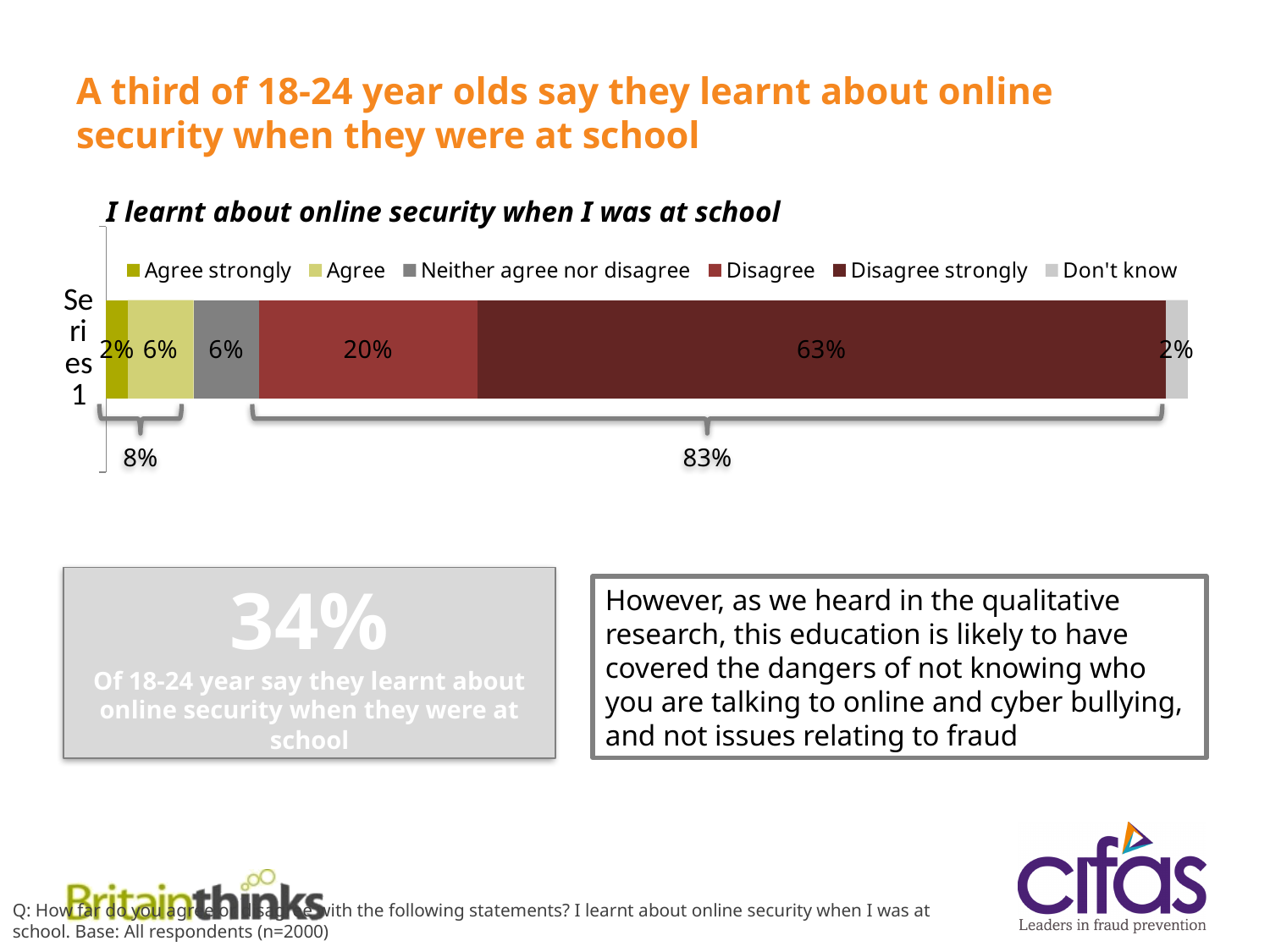
How many series does the chart legend list? 6 What is the difference between the 'Disagree strongly' and 'Disagree' percentages? 43 percentage points What percentage of respondents answered 'Disagree strongly' in the chart 'I learnt about online security when I was at school'? 63% What percentage of respondents answered 'Neither agree nor disagree' in the chart? 6% What is the combined percentage of 'Agree strongly' and 'Agree' shown by the bracket under the bar? 8% What type of chart is shown on the slide? Stacked bar chart Which response category has the largest share in the chart? Disagree strongly What is the combined percentage of 'Disagree' and 'Disagree strongly' shown by the bracket under the bar? 83% Which is larger in the chart: the 'Agree' share or the 'Disagree' share? Disagree What percentage of respondents answered 'Disagree' in the chart? 20% What percentage of respondents answered 'Agree strongly' in the chart? 2% What is the title of the chart on the slide? I learnt about online security when I was at school